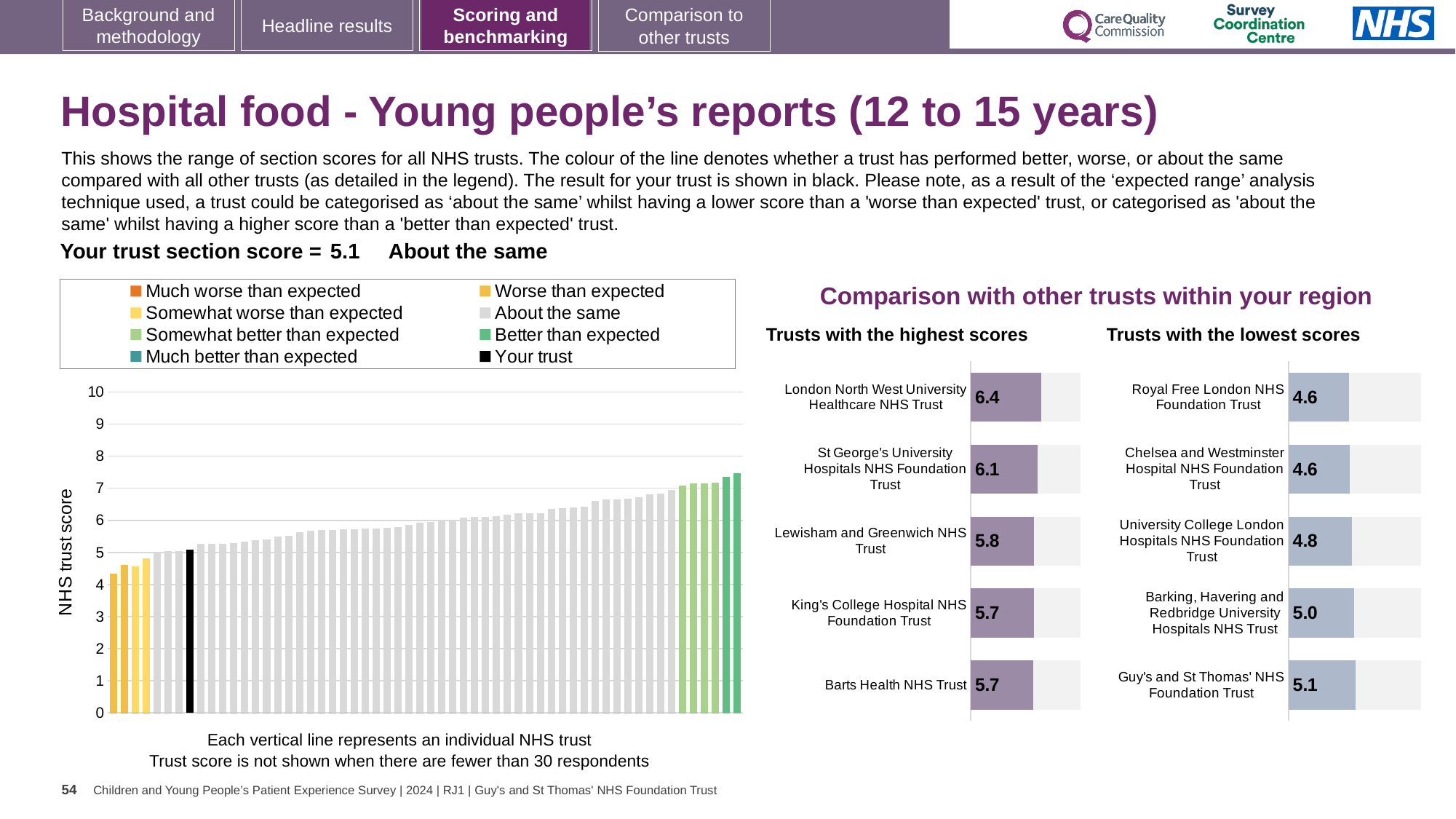
How many entries does the legend of the NHS trust score chart on the left list? 8 In the NHS trust score chart on the left, do the bar values rise or fall from left to right? rise In the 'Trusts with the lowest scores' chart, what is the score for University College London Hospitals NHS Foundation Trust? 4.8 In the NHS trust score chart on the left, is the value of the black 'Your trust' bar greater or less than 6? less In the 'Trusts with the highest scores' chart, what is the difference between the scores of London North West University Healthcare NHS Trust and St George's University Hospitals NHS Foundation Trust? 0.3 In the 'Trusts with the highest scores' chart, what is the score for London North West University Healthcare NHS Trust? 6.4 In the 'Trusts with the lowest scores' chart, how much higher is the score for Guy's and St Thomas' NHS Foundation Trust than for Royal Free London NHS Foundation Trust? 0.5 In the 'Trusts with the highest scores' chart, which has the larger score: Lewisham and Greenwich NHS Trust or King's College Hospital NHS Foundation Trust? Lewisham and Greenwich NHS Trust How many trusts are shown in the 'Trusts with the lowest scores' chart? 5 In the 'Trusts with the highest scores' chart, which trust has the highest score? London North West University Healthcare NHS Trust In the 'Trusts with the lowest scores' chart, which trust has the highest score? Guy's and St Thomas' NHS Foundation Trust What kind of chart is the NHS trust score chart on the left of the slide? bar chart